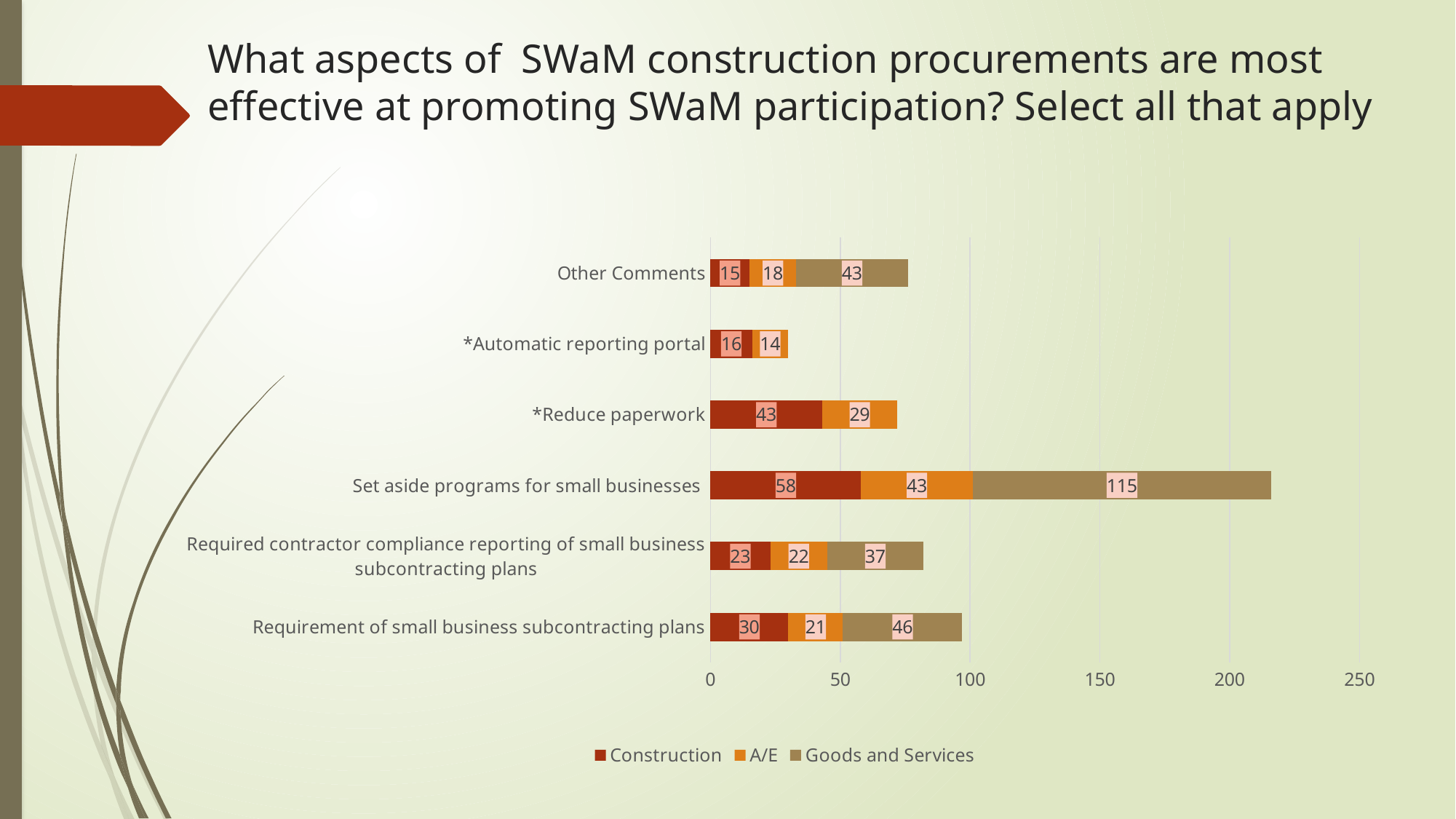
How many categories are shown on the chart? 6 Which is larger, the Construction value for *Reduce paperwork or the Construction value for Requirement of small business subcontracting plans? *Reduce paperwork What is the Goods and Services value for Set aside programs for small businesses? 115 Which series is shown in the darkest red colour in the legend? Construction What is the total of the stacked bar for Set aside programs for small businesses? 216 Which category has the longest total bar? Set aside programs for small businesses How many series does the legend list? 3 What is the Construction value for *Reduce paperwork? 43 Which category has the shortest total bar? *Automatic reporting portal What is the difference between the Goods and Services values for Requirement of small business subcontracting plans and Required contractor compliance reporting of small business subcontracting plans? 9 What is the A/E value for Other Comments? 18 What type of chart is shown on the slide? Stacked bar chart